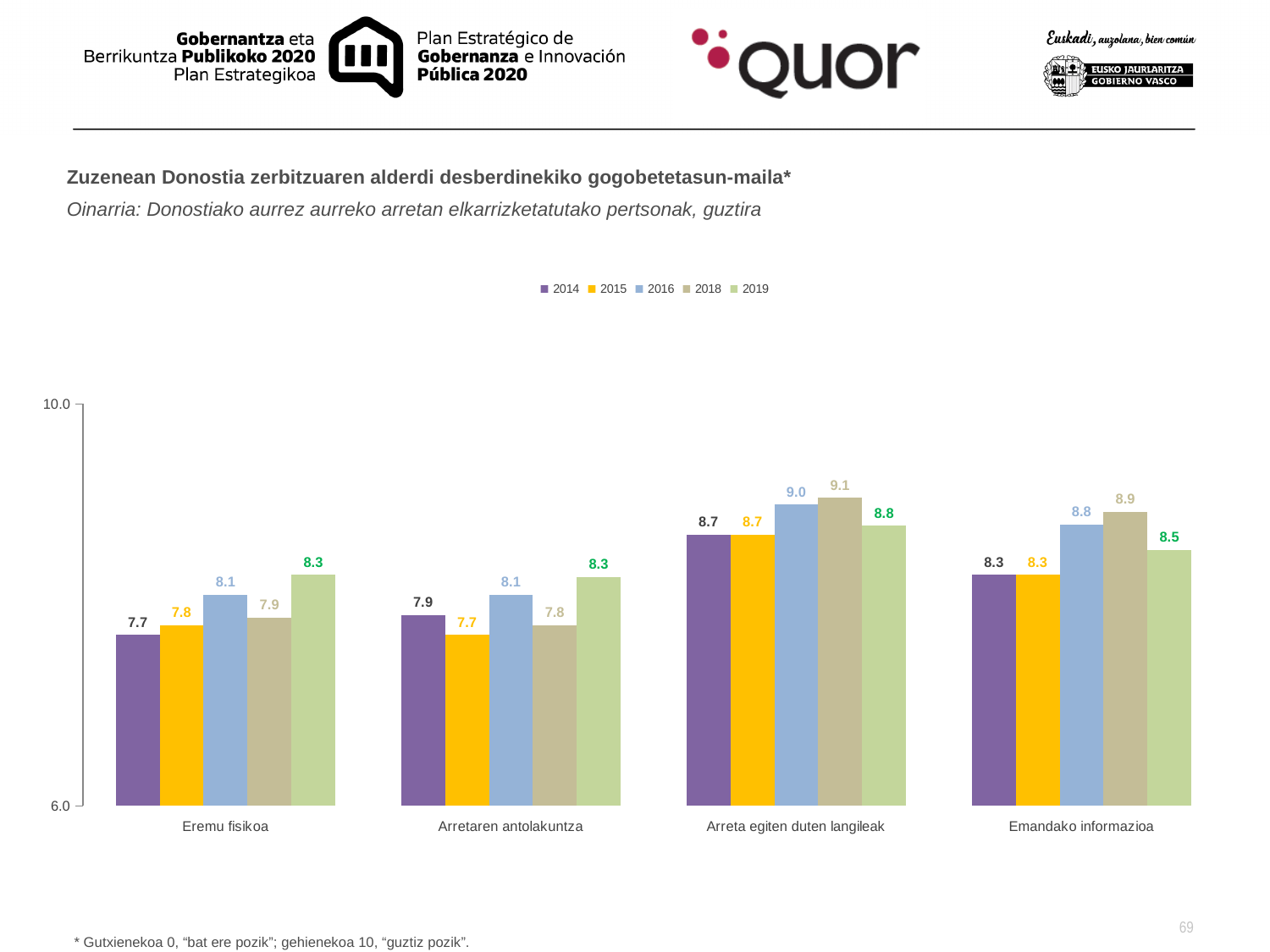
What is the value for 2016 in the Emandako informazioa category? 8.8 Which year has the lowest value in the Eremu fisikoa category? 2014 How many categories are shown on the x axis? 4 What is the difference between the 2019 and 2014 values in the Eremu fisikoa category? 0.6 Which years are listed in the legend? 2014, 2015, 2016, 2018, 2019 What is the value for 2015 in the Arretaren antolakuntza category? 7.7 What is the value for 2018 in the Arreta egiten duten langileak category? 9.1 What is the value for 2019 in the Eremu fisikoa category? 8.3 Which is larger: the 2018 value for Emandako informazioa or the 2018 value for Arretaren antolakuntza? Emandako informazioa Which year has the highest value in the Arreta egiten duten langileak category? 2018 How many series does the legend list? 5 What kind of chart is shown on the slide? Bar chart